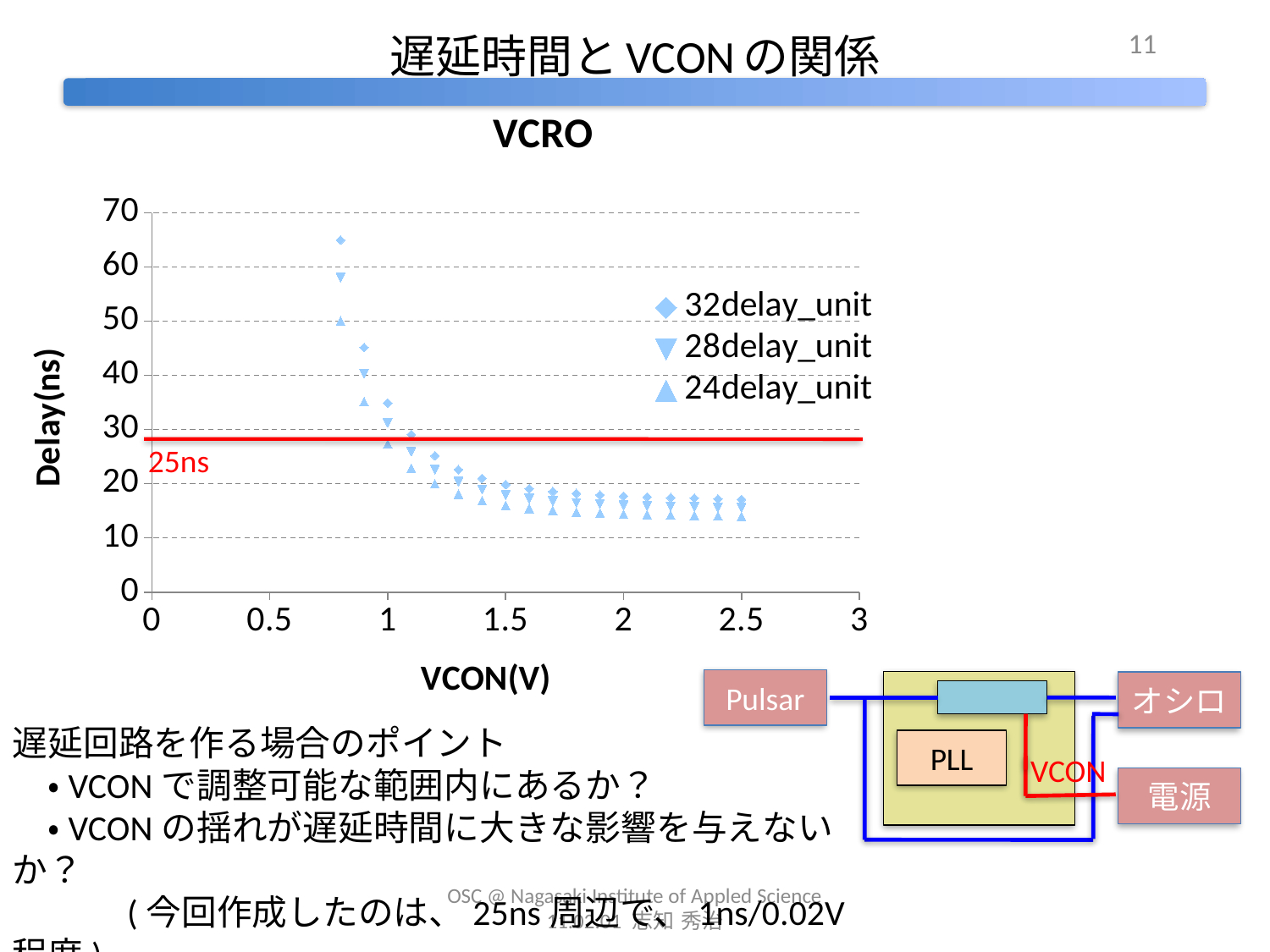
Is the delay of 32delay_unit at VCON = 2.5 V greater or less than 20 ns? less Is the delay of 32delay_unit at VCON = 0.8 V greater or less than 60 ns? greater What is the label of the y axis of the chart? Delay(ns) At VCON = 0.8 V, which series has the larger delay, 32delay_unit or 24delay_unit? 32delay_unit How many series does the legend of the VCRO chart list? 3 Which series has the lowest delay at VCON = 0.8 V? 24delay_unit What kind of chart is shown on the slide? scatter chart What is the title of the chart? VCRO Which series has the highest delay at VCON = 0.8 V? 32delay_unit Is the delay of 28delay_unit at VCON = 0.8 V greater or less than 50 ns? greater Do the delay values rise or fall as VCON increases along the x axis? fall